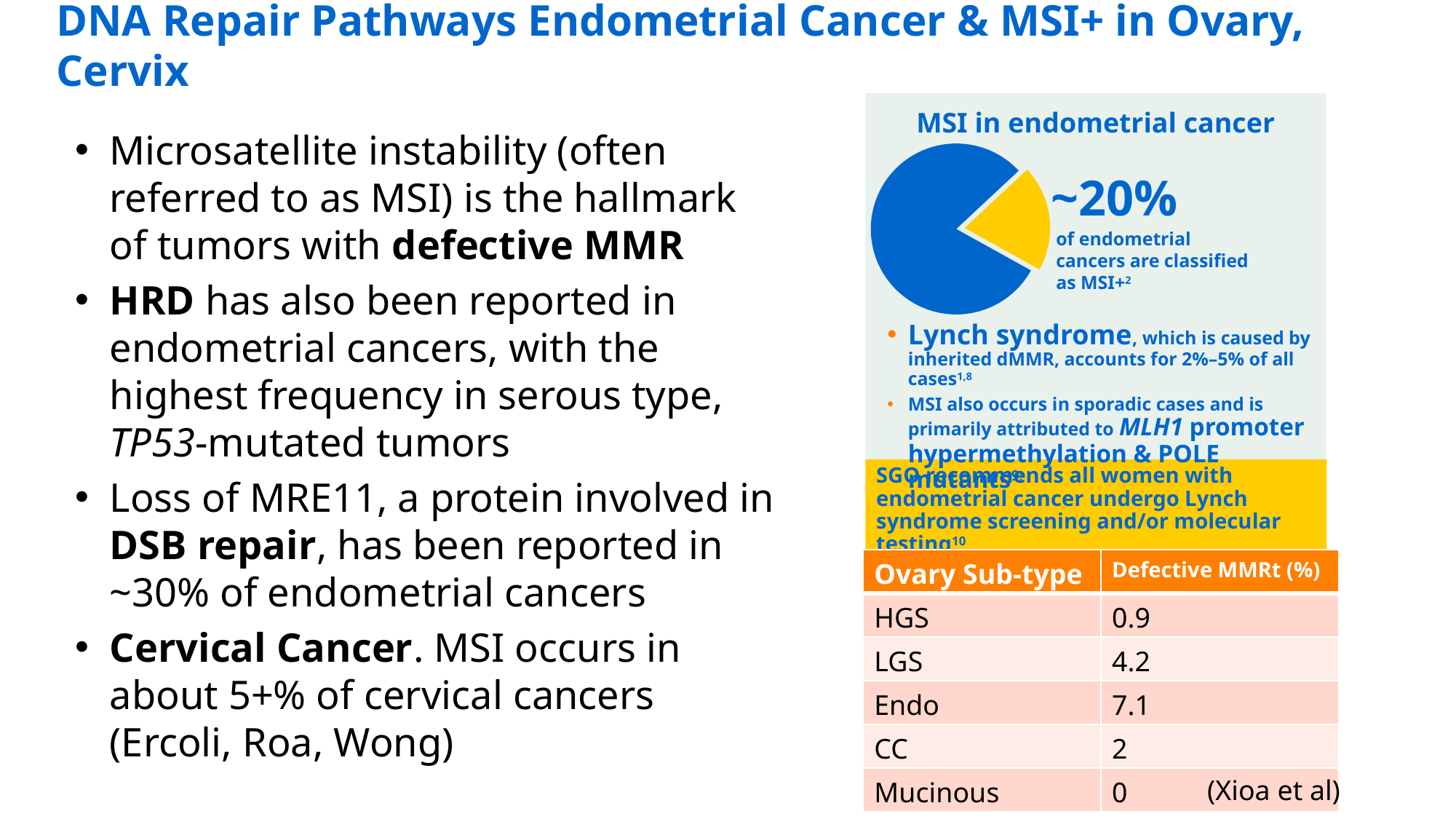
How many slices does the "MSI in endometrial cancer" pie chart have? 2 In the "MSI in endometrial cancer" pie chart, which slice is larger, the blue slice or the yellow slice? the blue slice In the "MSI in endometrial cancer" pie chart, what share of endometrial cancers are classified as MSI+? ~20% In the "MSI in endometrial cancer" pie chart, is the MSI+ slice greater or less than 50% of the pie? less What kind of chart is shown under the heading "MSI in endometrial cancer"? pie chart In the "MSI in endometrial cancer" pie chart, what colour is the slice representing MSI+ endometrial cancers? yellow What is the title of the pie chart on the slide? MSI in endometrial cancer